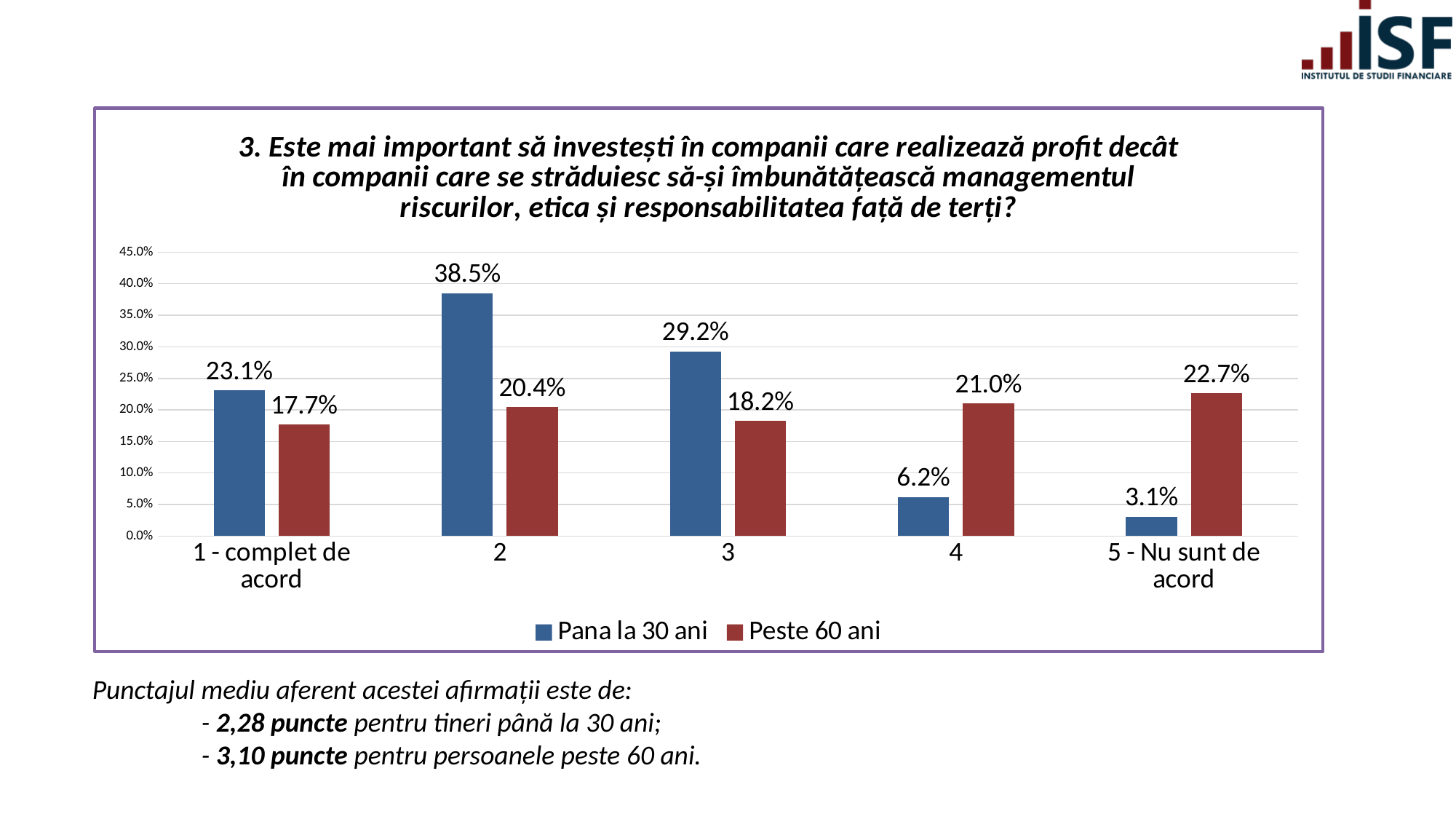
At category 4, which series has the larger value, 'Pana la 30 ani' or 'Peste 60 ani'? Peste 60 ani What kind of chart is shown on the slide? bar chart What is the value for 'Peste 60 ani' at category '5 - Nu sunt de acord'? 22.7% How many categories are shown on the x axis? 5 What is the value for 'Pana la 30 ani' at category 2? 38.5% Which category has the highest value for the 'Pana la 30 ani' series? 2 Is the value for 'Pana la 30 ani' at category 3 greater or less than 25.0%? greater Which category has the lowest value for the 'Peste 60 ani' series? 1 - complet de acord What is the difference between the 'Pana la 30 ani' and 'Peste 60 ani' values at category 2? 18.1% What is the value for 'Peste 60 ani' at category '1 - complet de acord'? 17.7% How many series does the legend list? 2 Which category has the lowest value for the 'Pana la 30 ani' series? 5 - Nu sunt de acord